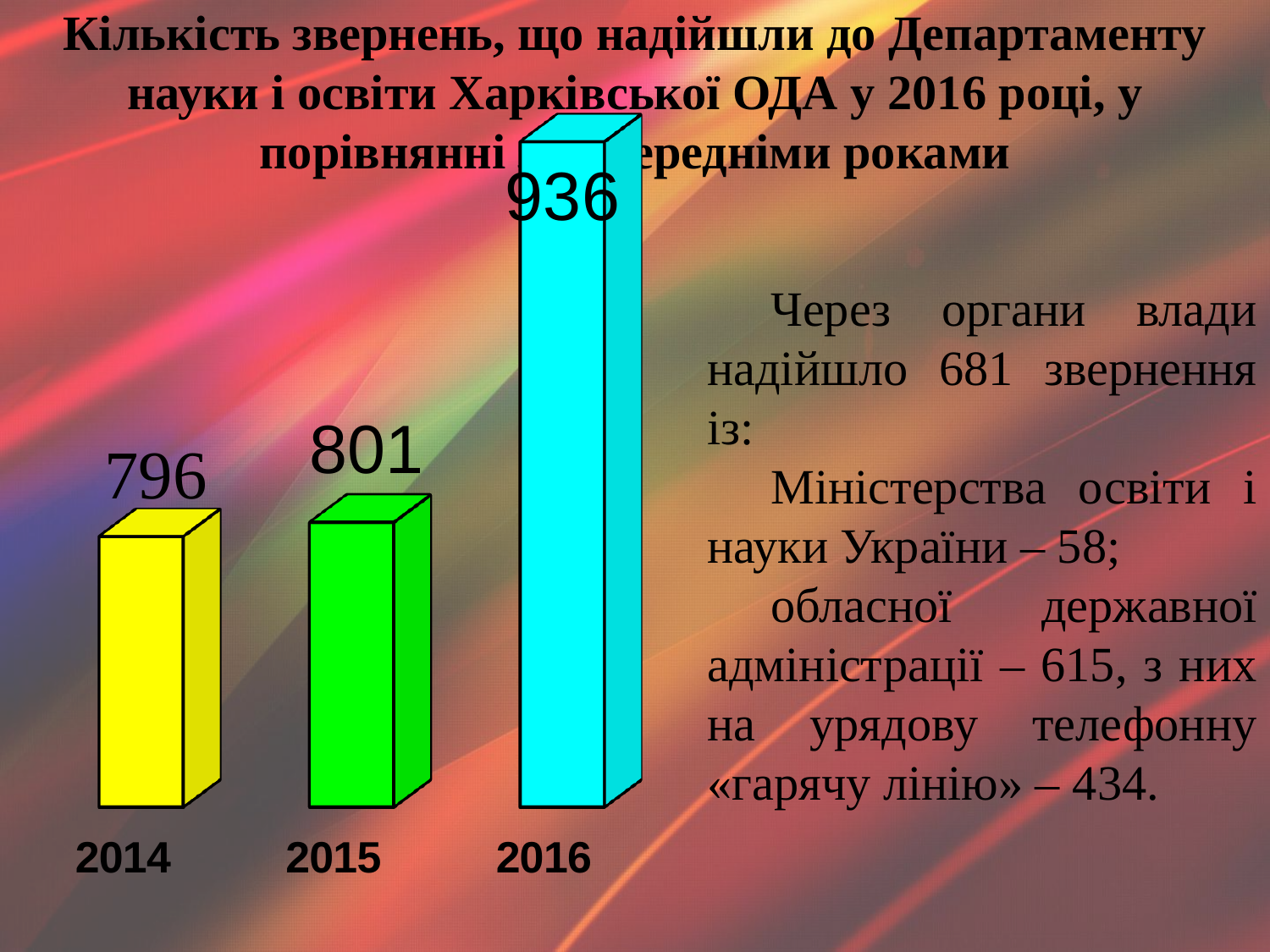
What is the difference between the values for 2016 and 2014? 140 What is the difference between the values for 2015 and 2014? 5 What is the value for 2016? 936 What is the value for 2014? 796 Which year has the highest value? 2016 How many years are shown in the chart? 3 Which year has the lowest value? 2014 What is the difference between the values for 2016 and 2015? 135 What is the value for 2015? 801 Do the values rise or fall from 2014 to 2016? rise What kind of chart is shown on the slide? bar chart Which is larger, the value for 2016 or the value for 2014? 2016